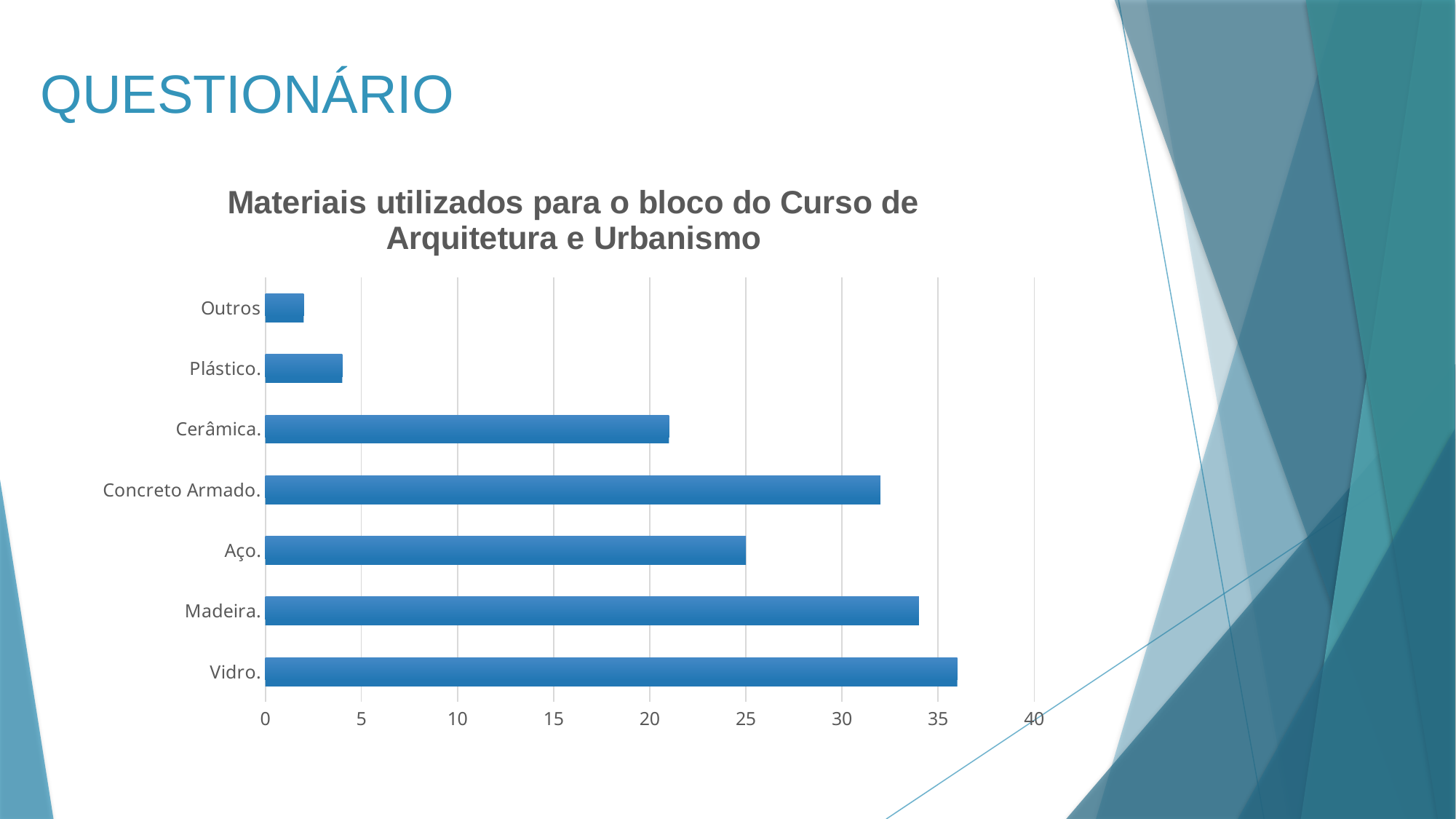
Which category has the lowest value? Outros Which has a larger value, Madeira. or Aço.? Madeira. How many material categories are plotted in the chart? 7 Which category has the highest value? Vidro. Is the value for Madeira. greater or less than 30? greater What kind of chart is shown on the slide? bar chart What is the value for Aço.? 25 Is the value for Cerâmica. greater or less than 25? less Which has a larger value, Concreto Armado. or Cerâmica.? Concreto Armado. Is the value for Plástico. greater or less than 5? less What is the title of the chart? Materiais utilizados para o bloco do Curso de Arquitetura e Urbanismo